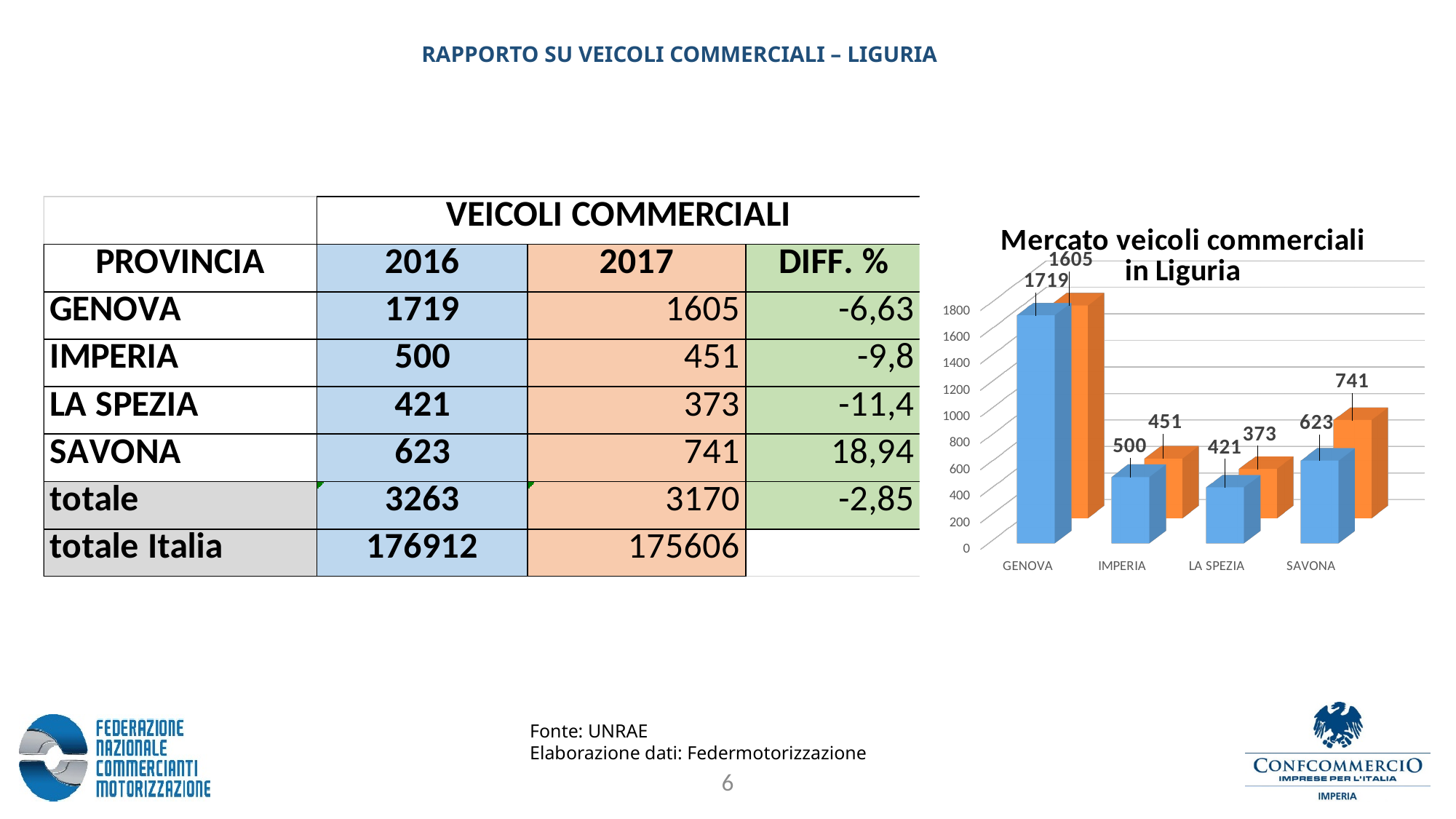
What is the value of the orange bar for LA SPEZIA? 373 What type of chart is shown on the slide? bar chart Is the value of the blue bar for SAVONA greater or less than 400? greater What is the difference between the blue and orange bars for GENOVA? 114 What is the title of the chart? Mercato veicoli commerciali in Liguria Which province has the highest orange bar? GENOVA What is the value of the blue bar for IMPERIA? 500 How many provinces are shown on the x axis of the chart? 4 What is the value of the blue bar for GENOVA? 1719 Which province has the lowest blue bar? LA SPEZIA What is the value of the orange bar for SAVONA? 741 For SAVONA, which is larger, the blue bar or the orange bar? orange bar